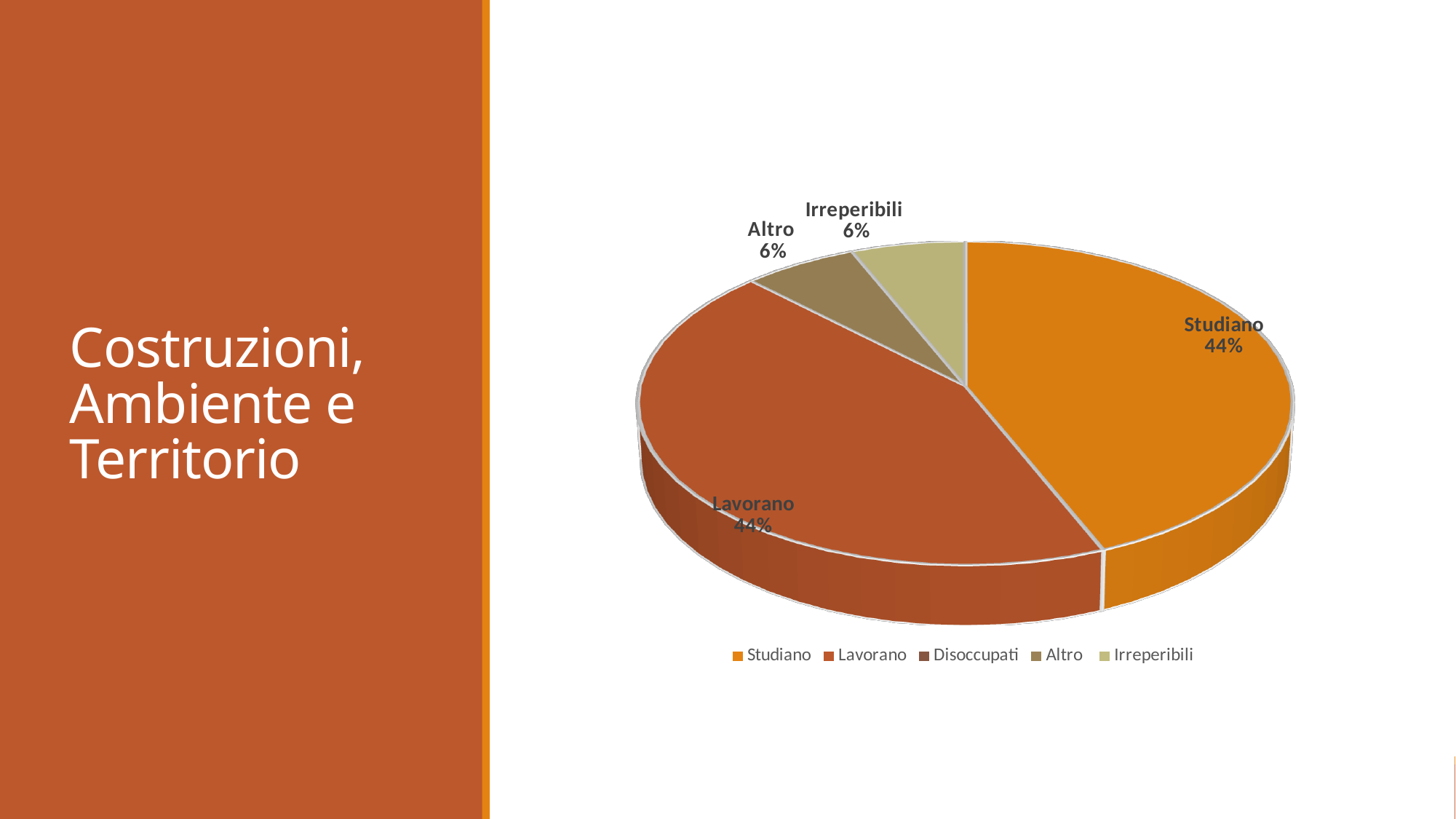
How many slices with data labels are visible in the pie chart? 4 What percentage of the pie chart is labelled Studiano? 44% Which is larger in the pie chart, Studiano or Altro? Studiano What percentage of the pie chart is labelled Lavorano? 44% Which legend entry has no visible slice in the pie chart? Disoccupati What share does the Irreperibili slice have in the pie chart? 6% What kind of chart is shown on the slide? Pie chart Which is larger in the pie chart, Lavorano or Irreperibili? Lavorano What is the combined share of the Studiano and Lavorano slices? 88% What is the difference in percentage points between the Studiano slice and the Altro slice? 38% What share does the Altro slice have in the pie chart? 6% How many entries does the chart legend list? 5